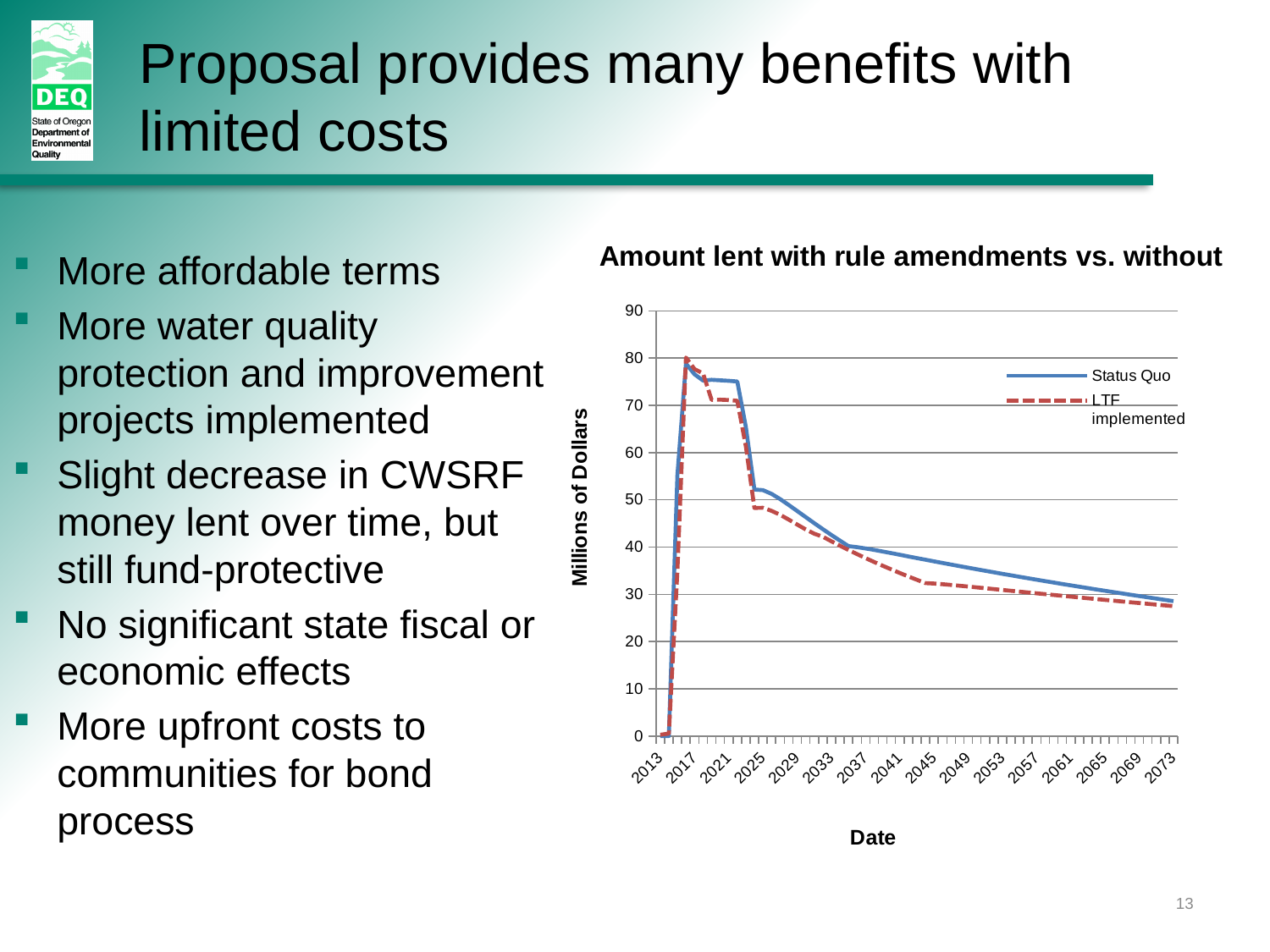
Is the Status Quo value in 2073 greater or less than 40? less Is the LTF implemented value in 2045 greater or less than 40? less How many series does the chart's legend list? 2 Is the Status Quo value in 2045 greater or less than 30? greater What kind of chart is shown on the slide? line chart How many year labels are shown on the x axis? 16 From 2025 to 2073, do the Status Quo values rise or fall? fall What is the label of the chart's vertical axis? Millions of Dollars In 2045, which series has the higher value, Status Quo or LTF implemented? Status Quo What is the title of the chart? Amount lent with rule amendments vs. without